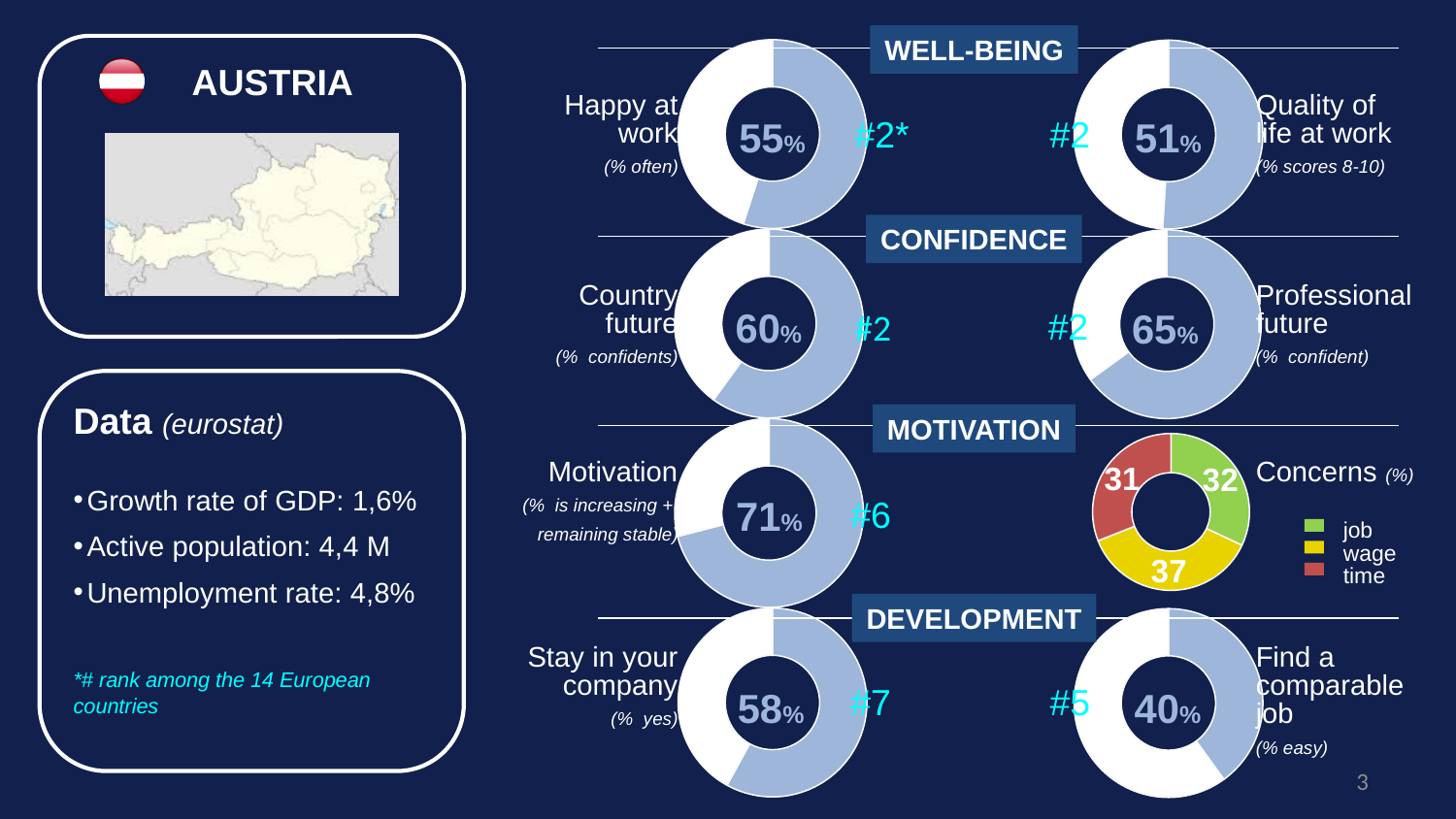
In the "Quality of life at work" donut chart, what percentage is shown? 51% In the "Concerns" donut chart, how many categories does the legend list? 3 In the "Motivation" donut chart, what percentage is shown? 71% In the "Concerns" donut chart, which category has the lowest value? time What is the difference between the "Professional future" percentage and the "Country future" percentage? 5% In the "Concerns" donut chart, which category has the highest value? wage In the "Happy at work" donut chart, what percentage is shown in the centre? 55% In the "Find a comparable job" donut chart, what percentage is shown? 40% Which is larger: the percentage in the "Stay in your company" chart or the percentage in the "Find a comparable job" chart? Stay in your company In the "Country future" donut chart, what percentage of respondents are confident? 60% In the "Concerns" donut chart, what is the value for wage? 37 In the "Professional future" donut chart, what percentage is shown? 65%